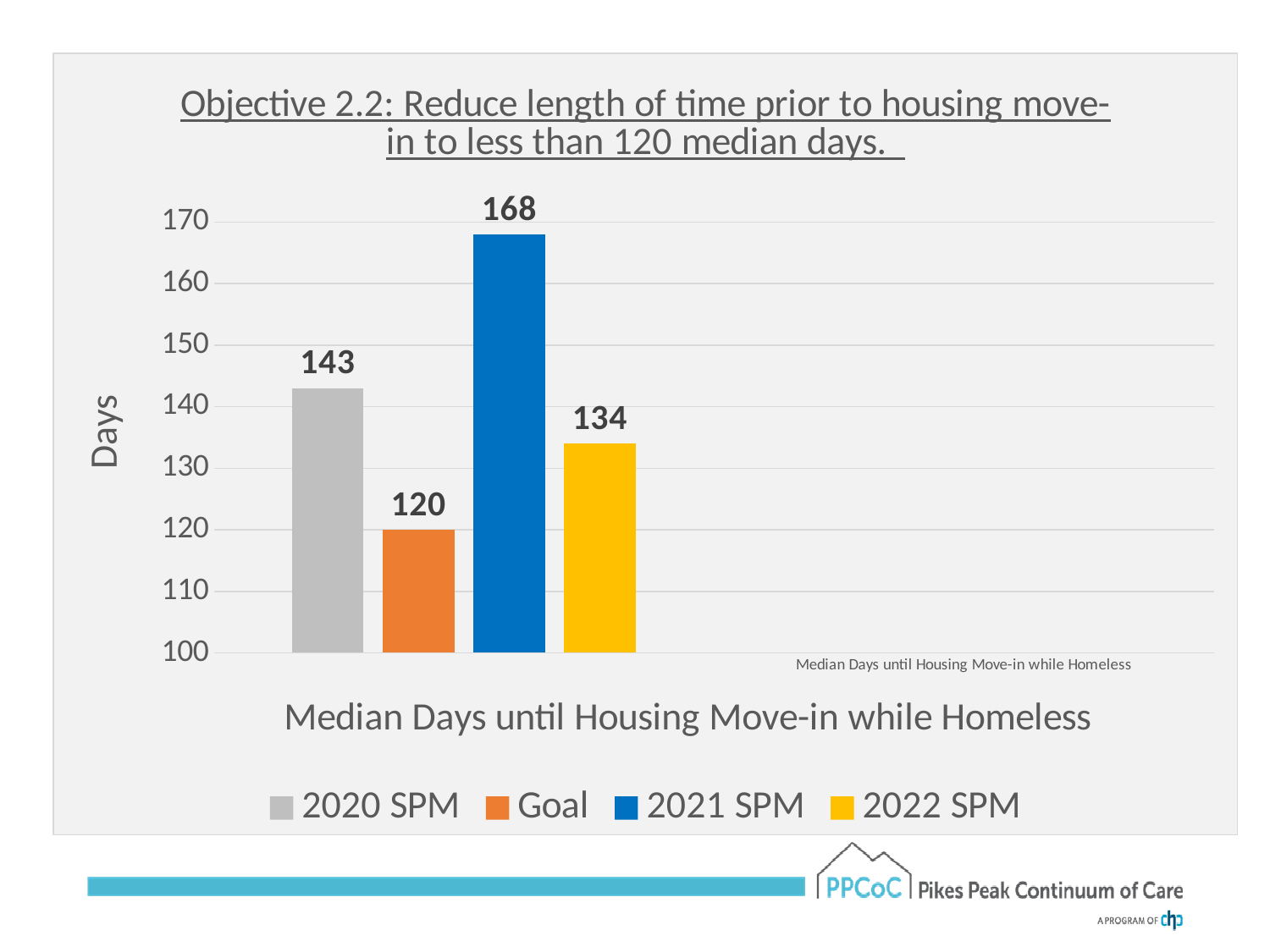
Which is larger, the 2020 SPM value or the 2022 SPM value? 2020 SPM What is the label on the vertical axis? Days How much higher is the 2020 SPM value than the Goal? 23 What is the value for 2021 SPM? 168 What kind of chart is shown on the slide? Bar chart Which series has the lowest value? Goal What is the value for 2022 SPM? 134 What is the value for the Goal bar? 120 Which series has the highest value? 2021 SPM How many series does the legend list? 4 What is the difference between the 2021 SPM and 2022 SPM values? 34 What is the value for 2020 SPM? 143